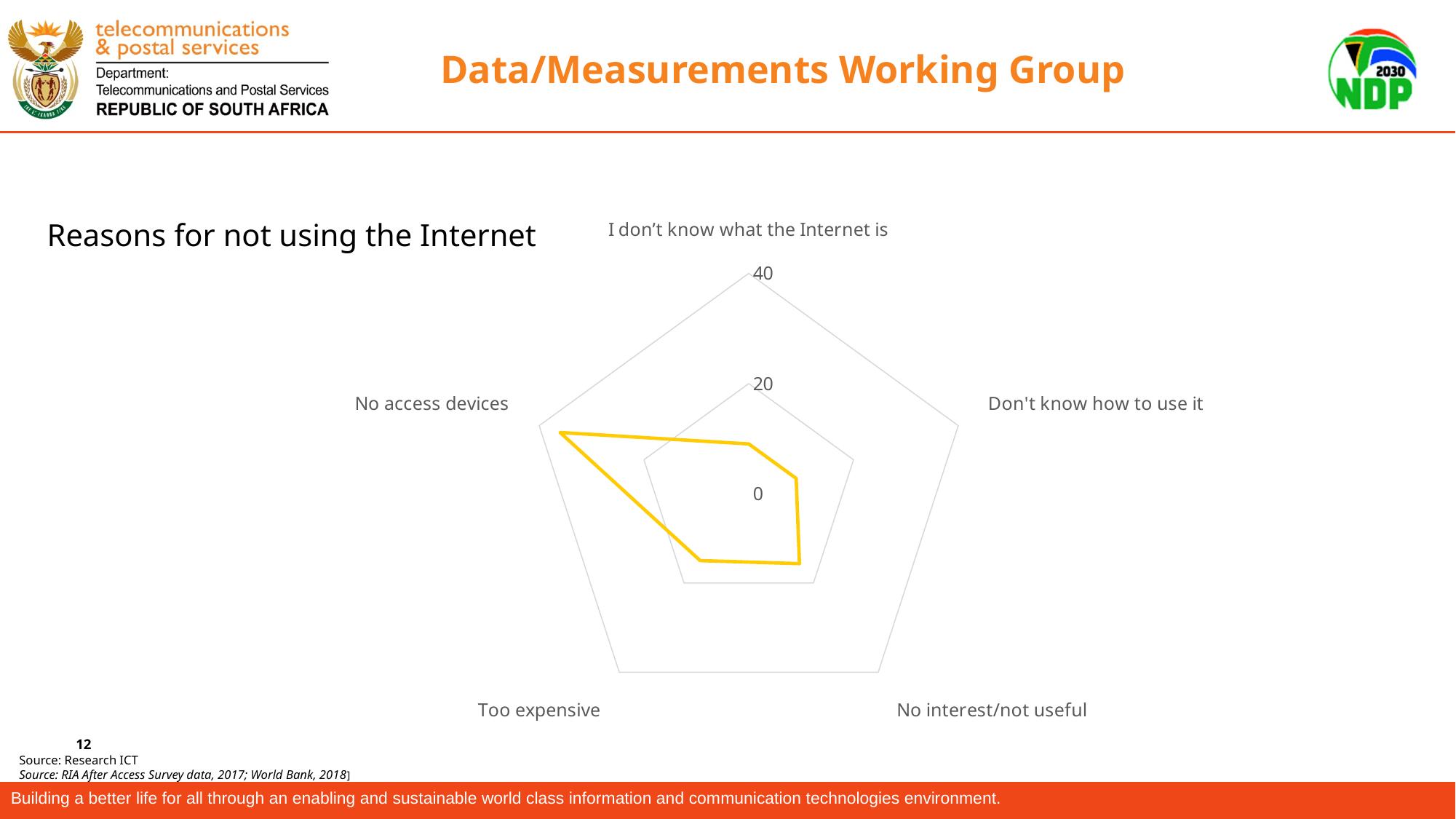
What kind of chart is shown on the slide? Radar chart Is the value for "No access devices" greater or less than 20? greater Is the value for "Too expensive" greater or less than 20? less Is the value for "I don't know what the Internet is" greater or less than 20? less What is the highest value shown on the chart's axis scale? 40 Which has the larger value: "No access devices" or "Too expensive"? No access devices What is the title of the chart? Reasons for not using the Internet How many reasons (categories) are plotted on the radar chart? 5 Which reason for not using the Internet has the highest value on the chart? No access devices Which has the larger value: "No interest/not useful" or "No access devices"? No access devices